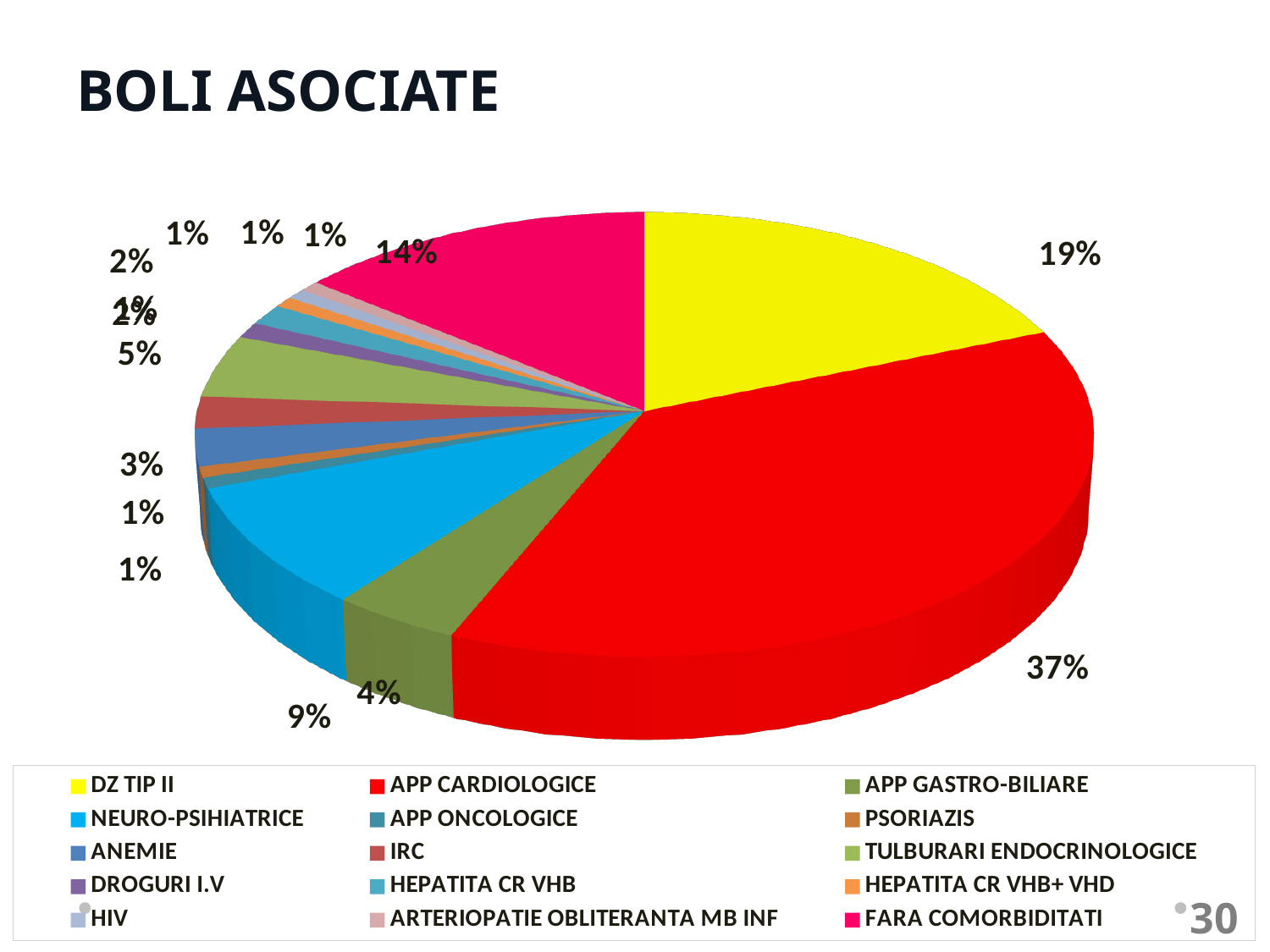
What is the difference in percentage points between APP CARDIOLOGICE and DZ TIP II? 18 Which category has the largest share of the pie? APP CARDIOLOGICE What percentage is shown for APP GASTRO-BILIARE? 4% Which has a larger share, DZ TIP II or FARA COMORBIDITATI? DZ TIP II What colour is the slice for APP CARDIOLOGICE? Red How many categories are listed in the legend? 15 What is the title of the chart? BOLI ASOCIATE What percentage is shown for FARA COMORBIDITATI? 14% What percentage is shown for NEURO-PSIHIATRICE? 9% What percentage of the pie does APP CARDIOLOGICE represent? 37% What percentage is shown for DZ TIP II? 19% What type of chart is shown on the slide? Pie chart